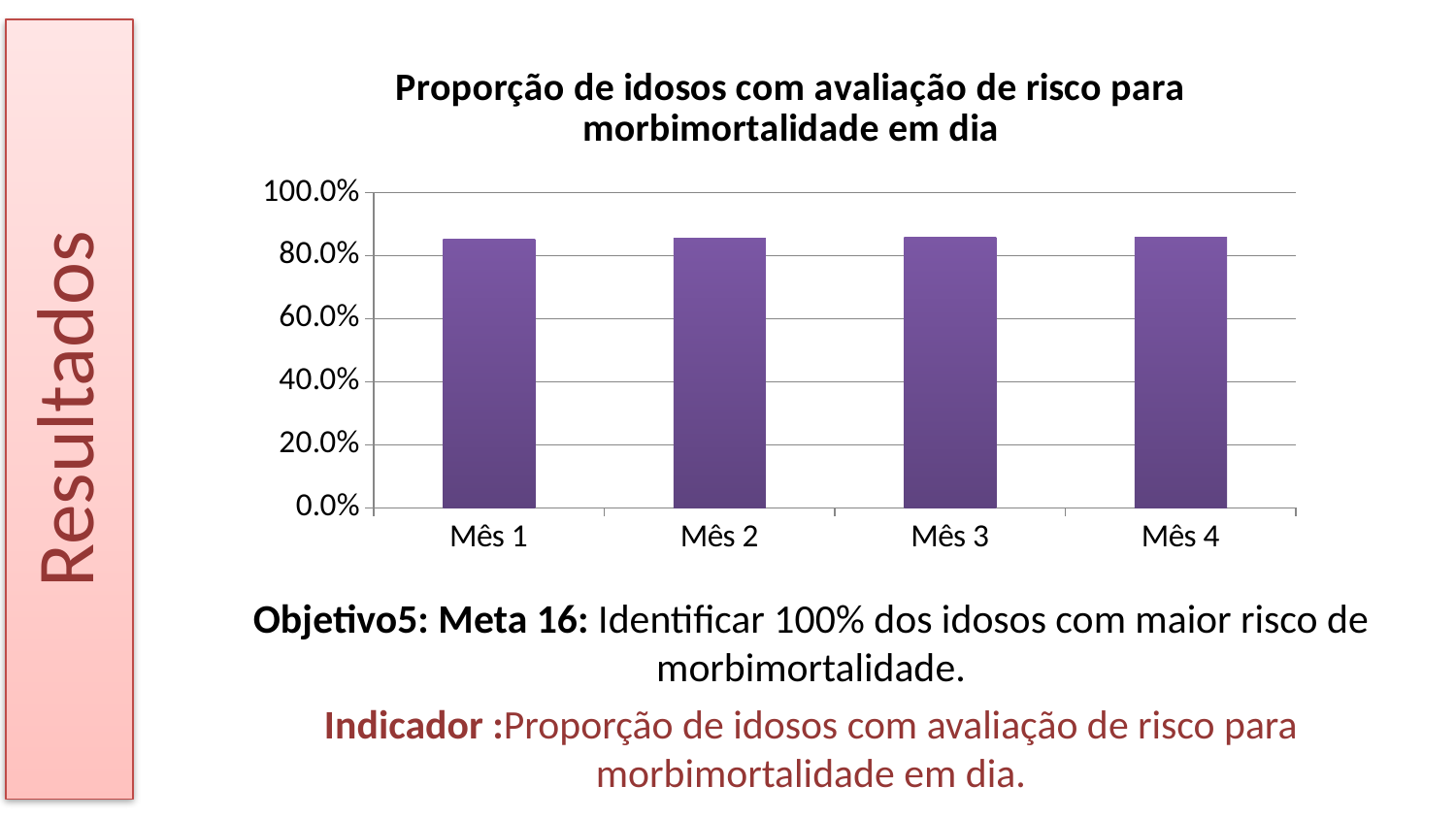
What is the label of the first category on the x axis? Mês 1 How many categories (months) are plotted on the x axis? 4 Is the value for Mês 3 greater or less than 60.0%? greater What kind of chart is shown on the slide? bar chart Is the value for Mês 2 greater or less than 100.0%? less What is the title of the chart? Proporção de idosos com avaliação de risco para morbimortalidade em dia What is the highest value shown on the y axis? 100.0% Is the value for Mês 4 greater or less than 80.0%? greater